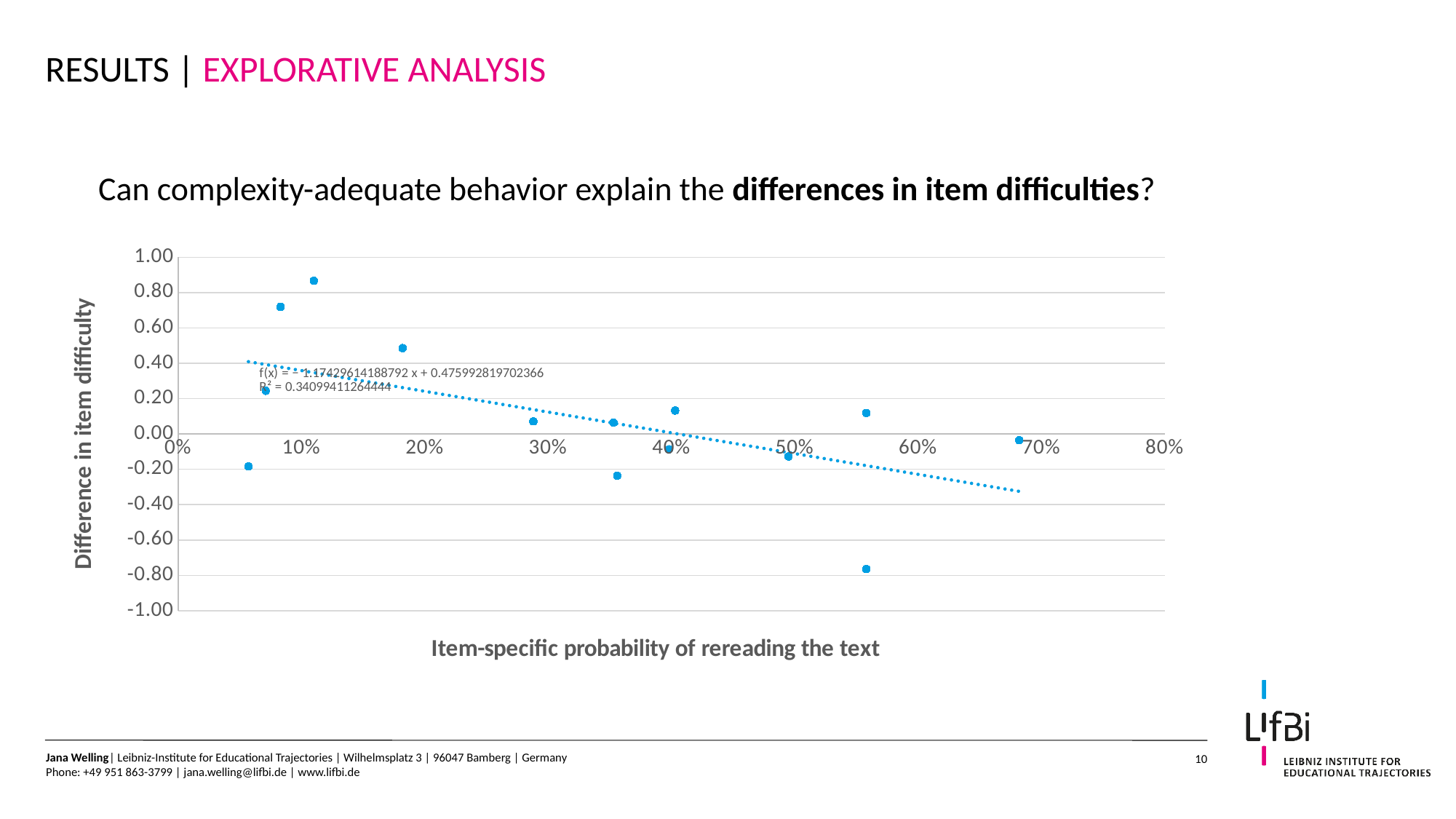
What is the title of the y axis of the chart? Difference in item difficulty What is the largest tick value shown on the x axis? 80% Is the lowest plotted point greater or less than -0.60 on the y axis? less Does the dotted trendline rise or fall as the probability of rereading the text increases? Fall Is the highest plotted point greater or less than 0.80 on the y axis? greater What is the title of the x axis of the chart? Item-specific probability of rereading the text What kind of chart is shown on the slide? Scatter plot What are the minimum and maximum tick values shown on the y axis? -1.00 and 1.00 Is the slope of the trendline positive or negative? Negative What R² value is printed for the trendline? R² = 0.34099411264444 Is the value of the point at roughly 68% rereading probability greater or less than 0.20? less What is the equation of the trendline printed on the chart? f(x) = -1.17429614188792 x + 0.475992819702366